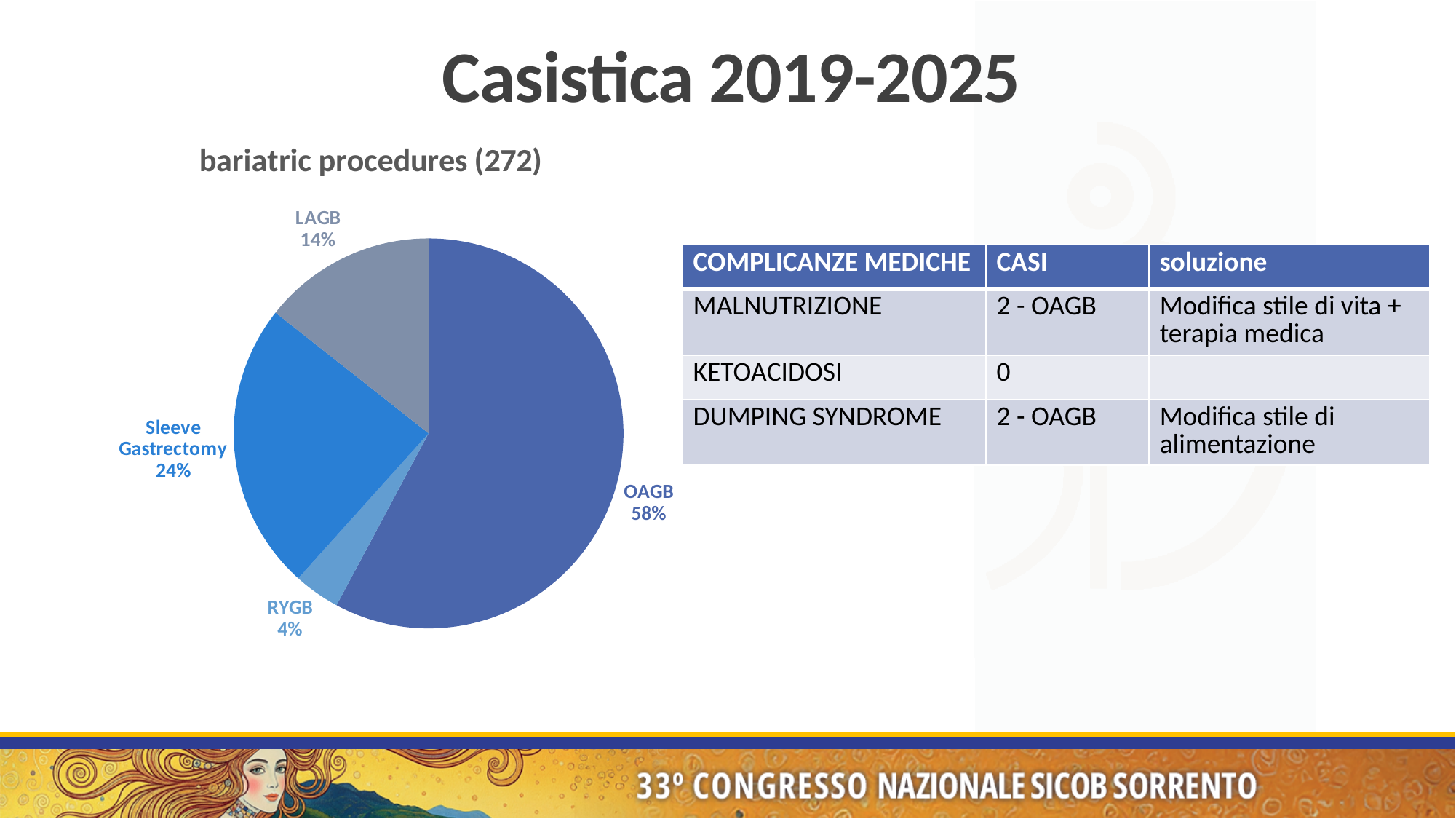
What is the difference in percentage points between LAGB and RYGB? 10 What is the difference in percentage points between OAGB and Sleeve Gastrectomy? 34 Which has a larger share, LAGB or Sleeve Gastrectomy? Sleeve Gastrectomy What share of the pie does Sleeve Gastrectomy represent? 24% What share of the pie does OAGB represent? 58% How many slices does the pie chart have? 4 What share of the pie does LAGB represent? 14% Which procedure has the smallest share of the pie? RYGB What kind of chart is shown on the slide? pie chart Which procedure has the largest share of the pie? OAGB What is the title of the chart? bariatric procedures (272) What share of the pie does RYGB represent? 4%